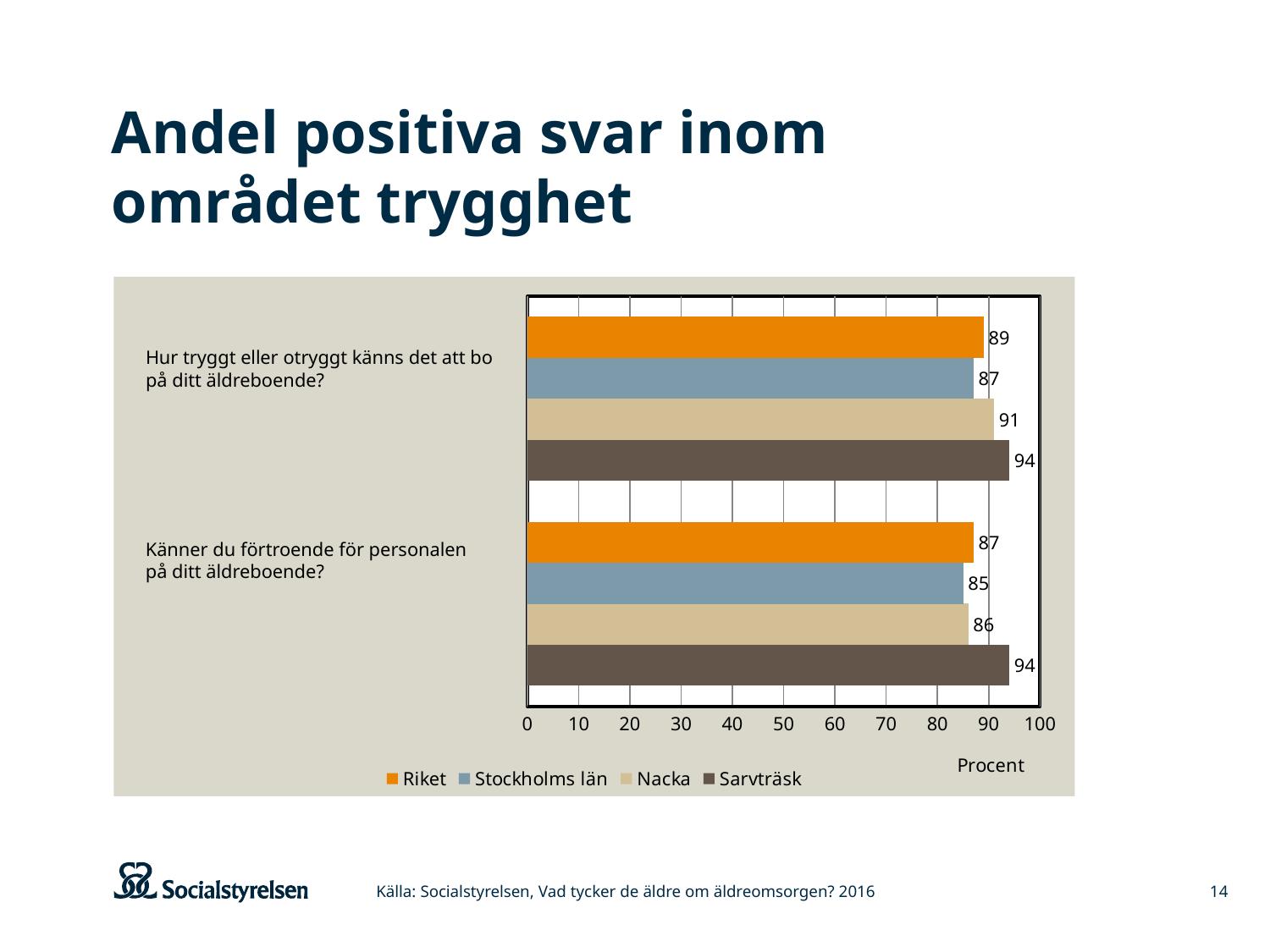
Which series has the lowest value on the question "Hur tryggt eller otryggt känns det att bo på ditt äldreboende?"? Stockholms län What kind of chart is shown on the slide? Bar chart What unit is shown on the x axis of the chart? Procent Which series has the highest value on the question "Känner du förtroende för personalen på ditt äldreboende?"? Sarvträsk What is the value for Sarvträsk on the question "Hur tryggt eller otryggt känns det att bo på ditt äldreboende?"? 94 What is the value for Nacka on the question "Känner du förtroende för personalen på ditt äldreboende?"? 86 What is the difference between Sarvträsk and Stockholms län on the question "Känner du förtroende för personalen på ditt äldreboende?"? 9 Which is larger on the question "Hur tryggt eller otryggt känns det att bo på ditt äldreboende?": Nacka or Riket? Nacka What is the value for Riket on the question "Känner du förtroende för personalen på ditt äldreboende?"? 87 How many questions (categories) are shown on the chart? 2 How many series does the legend list? 4 What is the value for Stockholms län on the question "Hur tryggt eller otryggt känns det att bo på ditt äldreboende?"? 87